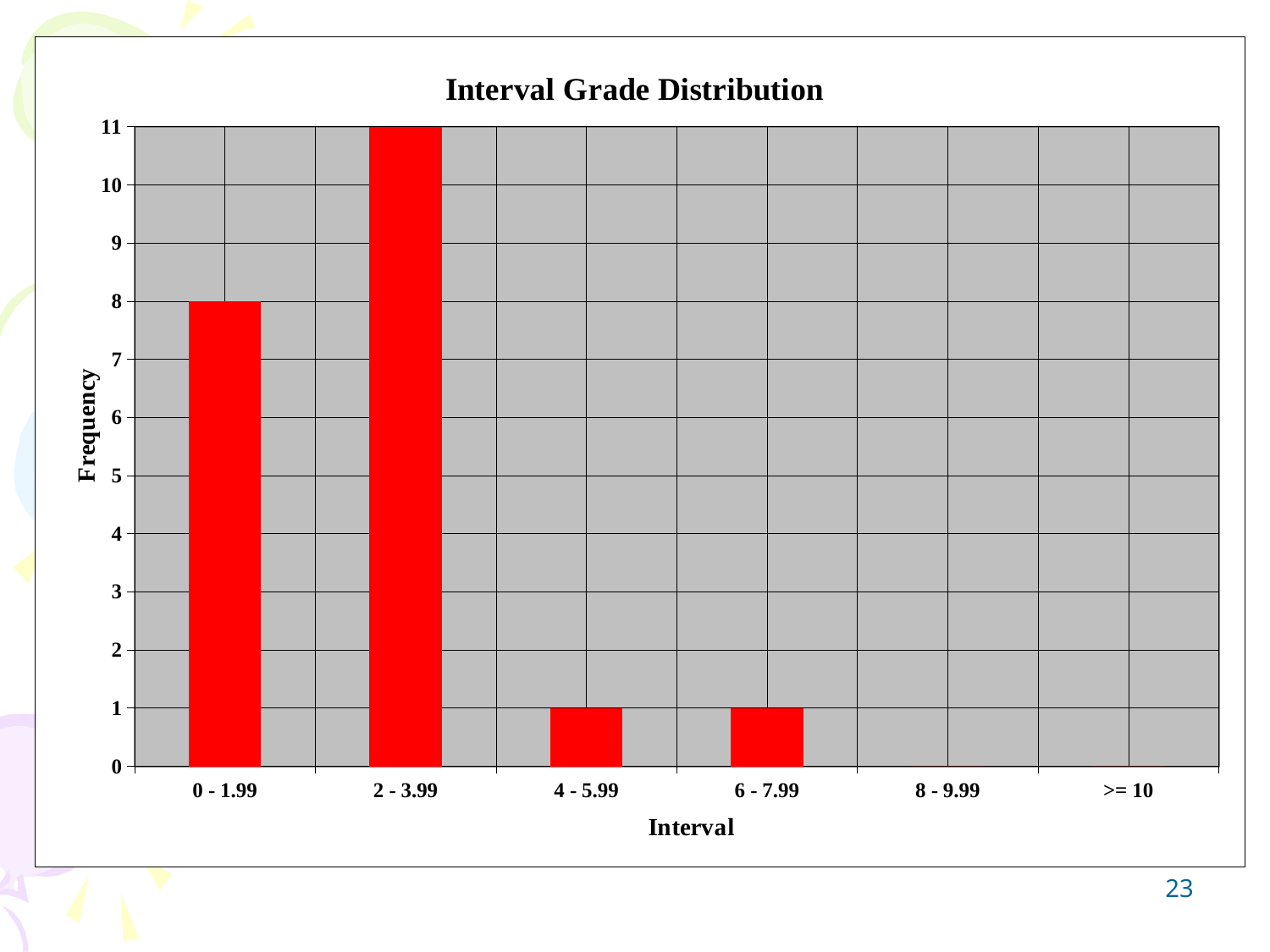
What is the label of the y axis? Frequency Is the frequency for the 0 - 1.99 interval greater or less than 5? greater What is the difference in frequency between the 2 - 3.99 interval and the 0 - 1.99 interval? 3 What is the frequency for the interval 8 - 9.99? 0 Which interval has the highest frequency? 2 - 3.99 What kind of chart is shown on the slide? bar chart What is the frequency for the interval 2 - 3.99? 11 What is the frequency for the interval 0 - 1.99? 8 Which has a larger frequency, the 0 - 1.99 interval or the 6 - 7.99 interval? 0 - 1.99 What is the frequency for the interval 4 - 5.99? 1 How many intervals are shown on the x axis? 6 What is the title of the chart? Interval Grade Distribution